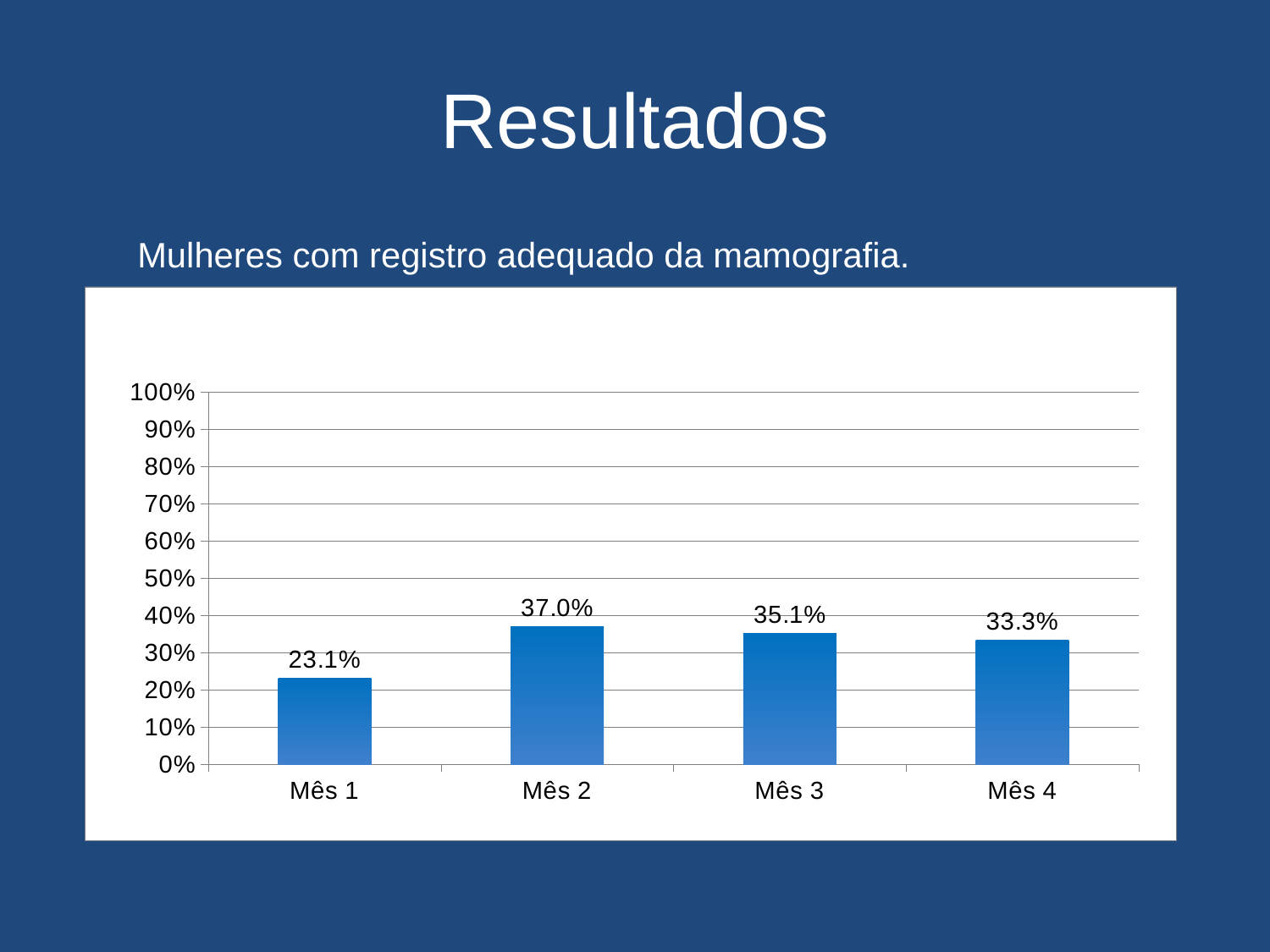
What is the value for Mês 3? 35.1% Which month has the highest value? Mês 2 What kind of chart is shown on the slide? bar chart Do the values rise or fall from Mês 2 to Mês 4? fall What is the difference between the values for Mês 2 and Mês 1? 13.9% How many months are shown on the x axis? 4 What is the value for Mês 4? 33.3% What is the value for Mês 2? 37.0% Is the value for Mês 1 greater or less than 30%? less Which month has the lowest value? Mês 1 What is the value for Mês 1? 23.1% Which is larger, the value for Mês 3 or the value for Mês 4? Mês 3